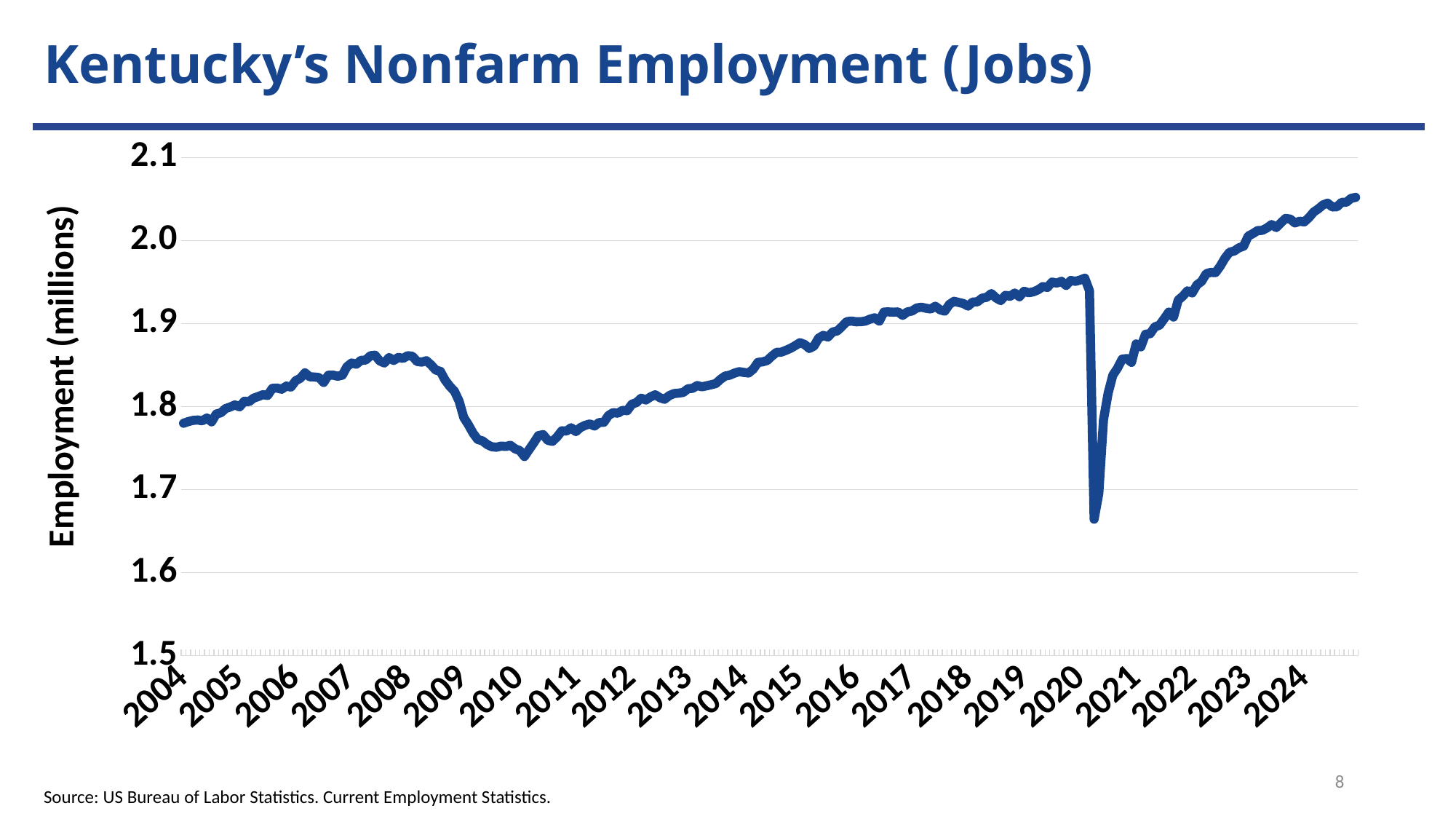
What is the title of the chart? Kentucky's Nonfarm Employment (Jobs) Is the value at the start of 2004 greater or less than 1.8? less Is the value at the start of 2010 greater or less than 1.8? less Overall, does employment rise or fall from 2004 to 2024? rise Is the value at the lowest point of the 2020 dip greater or less than 1.7? less How many year labels are shown on the horizontal axis? 21 In which year does the line reach its lowest point? 2020 What kind of chart is shown on the slide? line chart In which year does the line reach its highest point? 2024 What is the label on the vertical axis? Employment (millions)